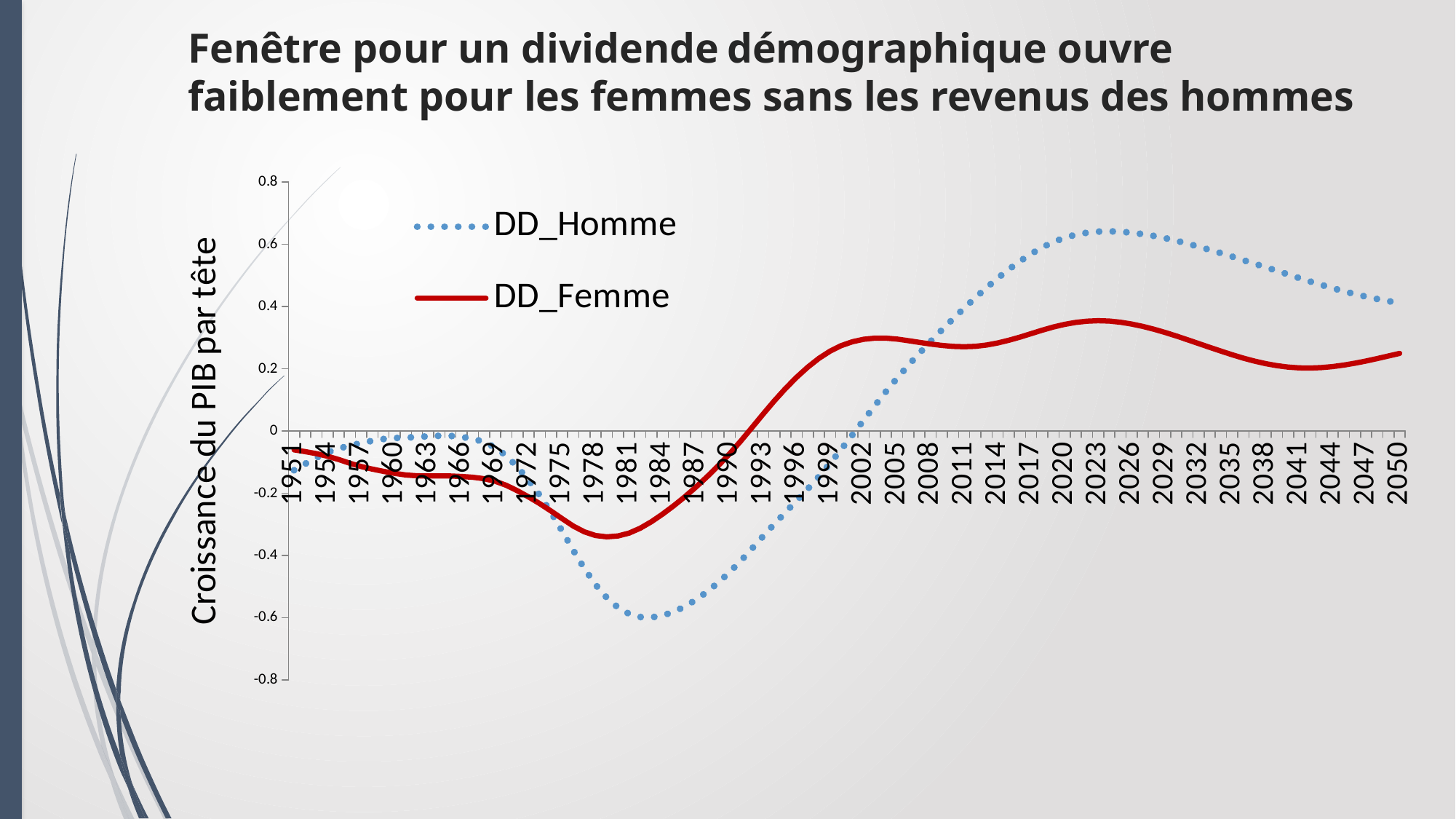
What kind of chart is shown on the slide? line chart Around 2023, which series has the higher value, DD_Homme or DD_Femme? DD_Homme How many year labels are shown along the x axis? 34 Which series reaches the lowest value on the chart? DD_Homme What are the two series named in the legend? DD_Homme and DD_Femme Does DD_Homme rise or fall between 2023 and 2050? fall Is the value of DD_Homme around 2023 greater or less than 0.6? greater What is the label of the vertical axis? Croissance du PIB par tête Is the value of DD_Homme around 1981 greater or less than -0.4? less Is the value of DD_Femme around 2023 greater or less than 0.4? less How many series does the legend list? 2